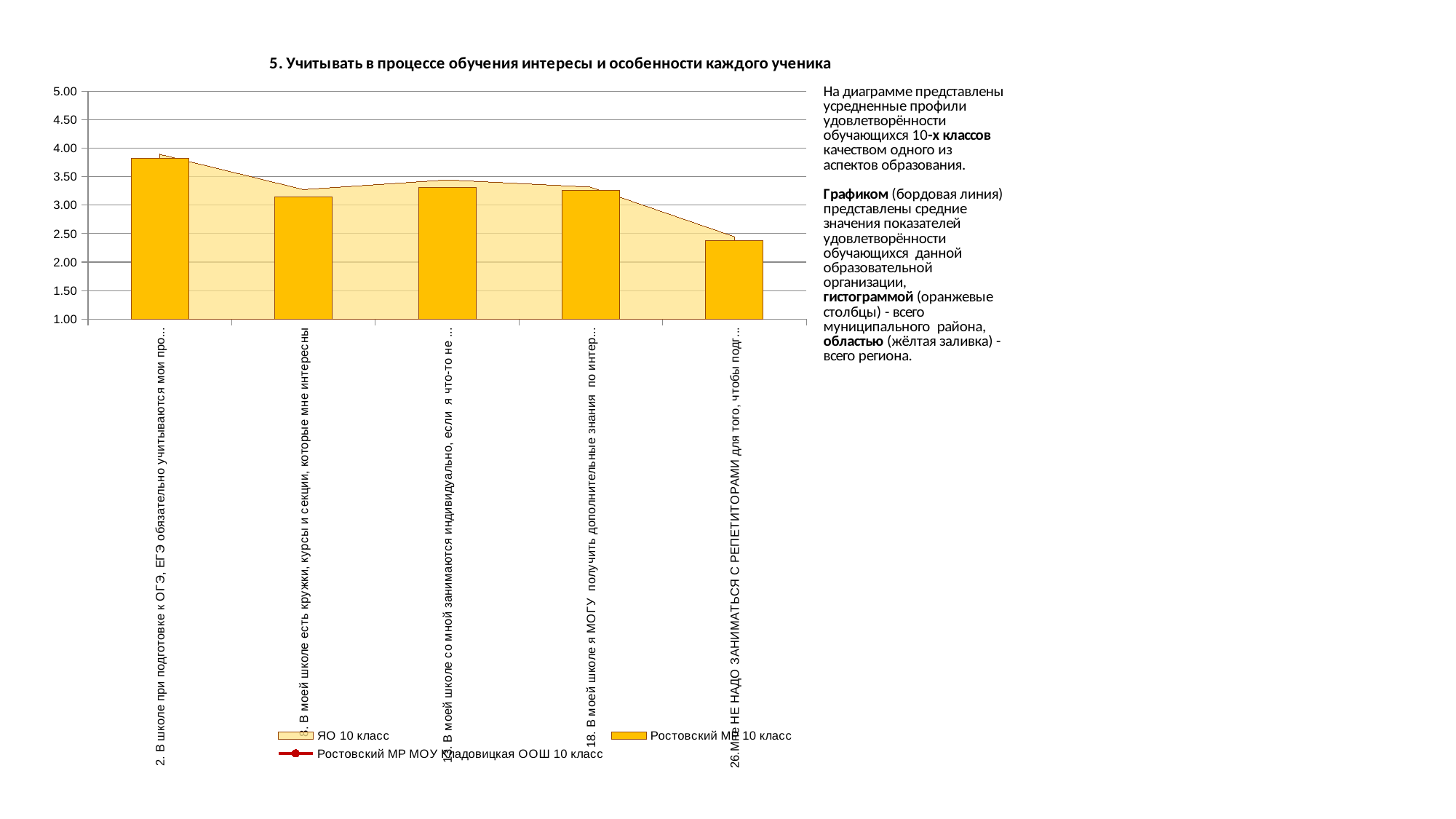
Is the Ростовский МР 10 класс value for category 26 (МНЕ НЕ НАДО ЗАНИМАТЬСЯ С РЕПЕТИТОРАМИ...) greater or less than 2.50? less Which has the larger Ростовский МР 10 класс value: category 2 (В школе при подготовке к ОГЭ, ЕГЭ...) or category 26 (МНЕ НЕ НАДО ЗАНИМАТЬСЯ С РЕПЕТИТОРАМИ...)? Category 2 What is the highest value shown on the vertical axis of the chart? 5.00 Which series is drawn as orange bars in the chart? Ростовский МР 10 класс What is the title of the chart? 5. Учитывать в процессе обучения интересы и особенности каждого ученика Which category has the lowest orange bar (Ростовский МР 10 класс)? 26. МНЕ НЕ НАДО ЗАНИМАТЬСЯ С РЕПЕТИТОРАМИ для того, чтобы подг... Do the Ростовский МР 10 класс values overall rise or fall from the first category to the last category along the x axis? fall Is the Ростовский МР 10 класс value for category 8 (В моей школе есть кружки, курсы и секции...) greater or less than 3.00? greater Is the Ростовский МР 10 класс value for category 2 (В школе при подготовке к ОГЭ, ЕГЭ...) greater or less than 3.50? greater How many categories are shown along the x axis of the chart? 5 How many series does the chart legend list? 3 Which category has the highest orange bar (Ростовский МР 10 класс)? 2. В школе при подготовке к ОГЭ, ЕГЭ обязательно учитываются мои про...